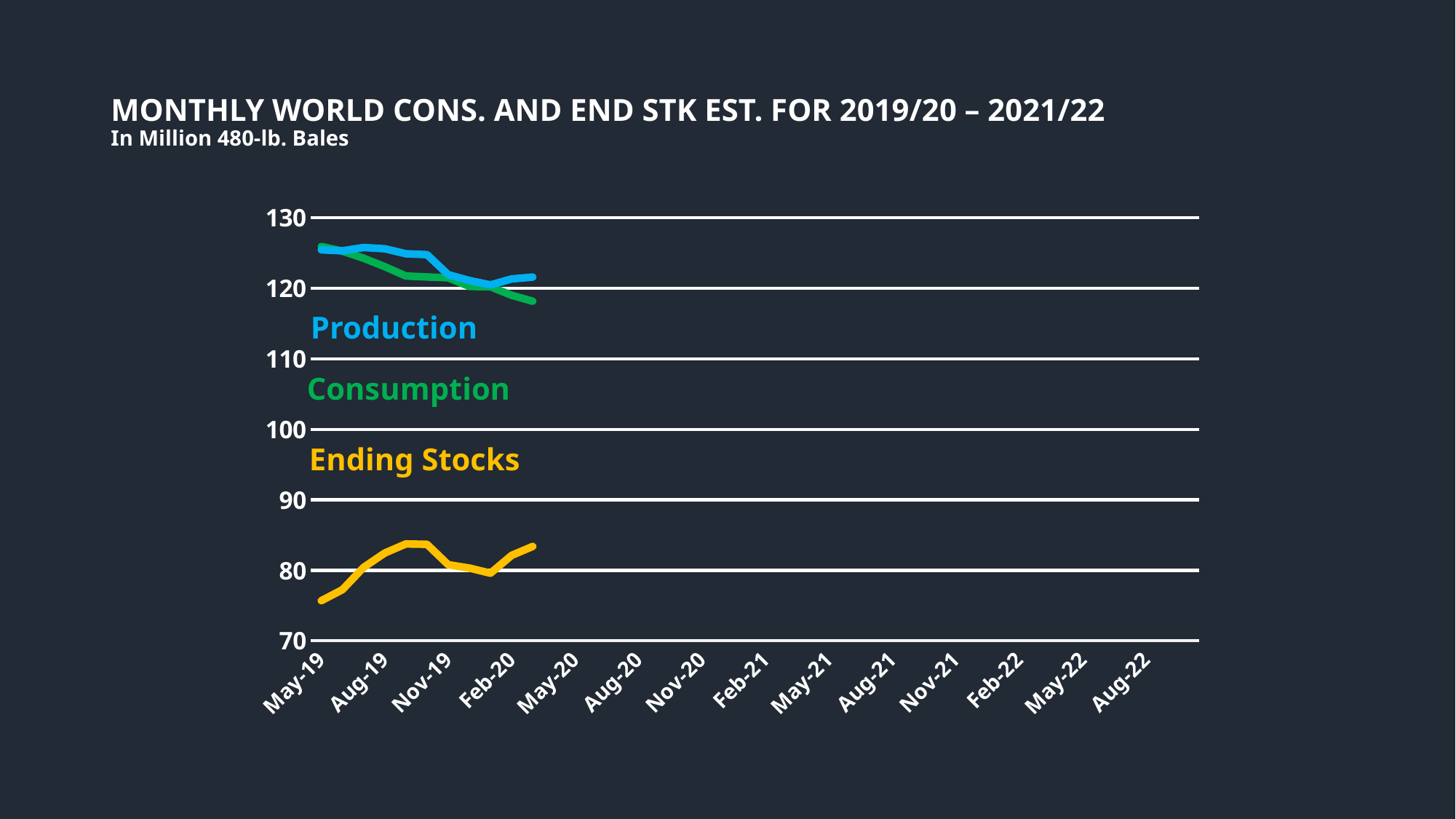
Does the Consumption line rise or fall from May-19 to Feb-20? fall What is the title of the chart? MONTHLY WORLD CONS. AND END STK EST. FOR 2019/20 – 2021/22 Is the value for Ending Stocks at Nov-19 greater or less than 90? less Is the value for Ending Stocks at May-19 greater or less than 80? less Which series has the lowest values on the chart? Ending Stocks How many series are plotted on the chart? 3 Is the value for Production at May-19 greater or less than 120? greater Which is larger at May-19, Production or Ending Stocks? Production What kind of chart is shown on the slide? line chart What unit is stated in the chart's subtitle? In Million 480-lb. Bales How many month labels are shown on the x axis? 14